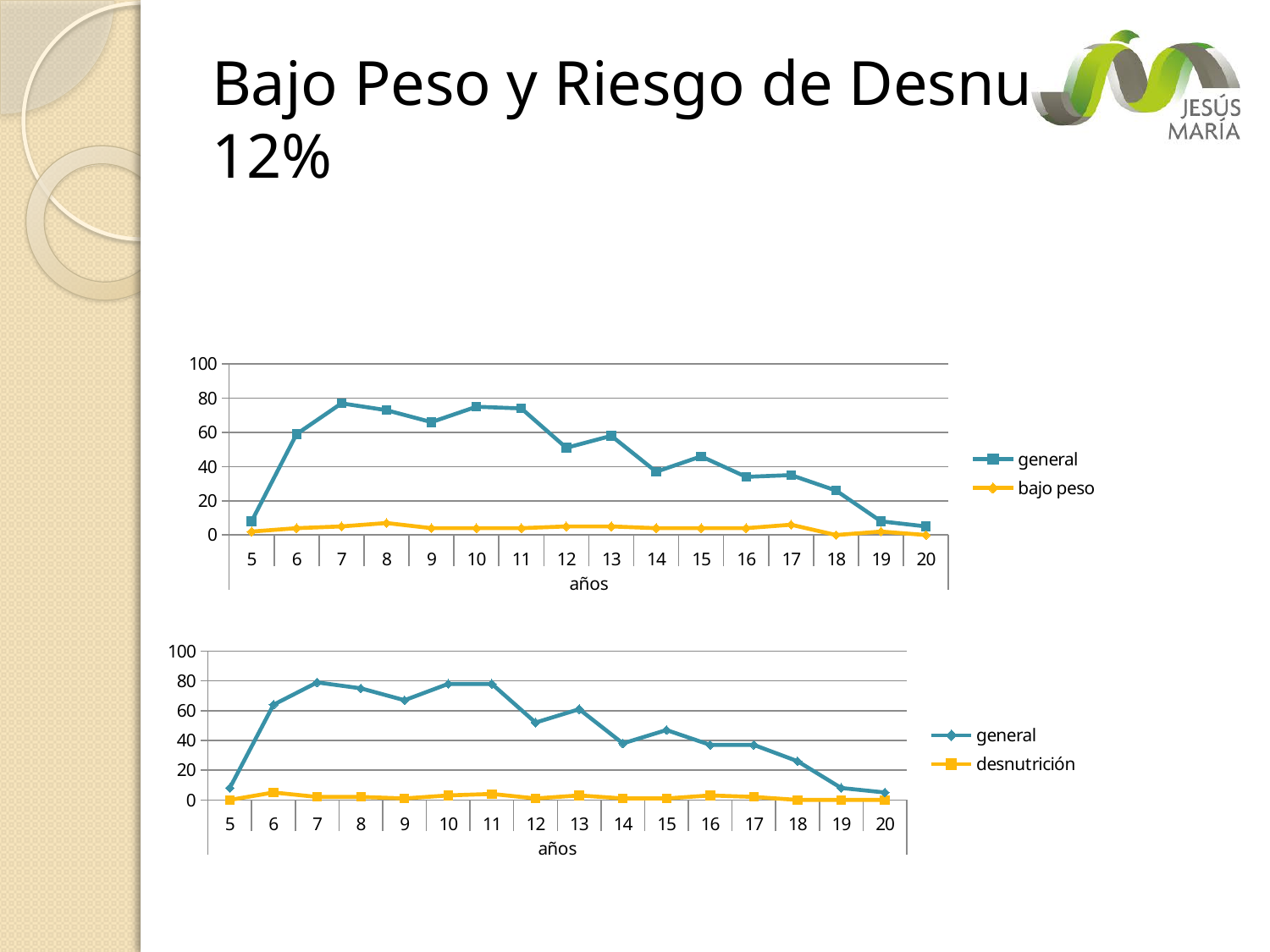
In the bottom chart, which is larger for the 'general' series: the value at 7 años or at 12 años? 7 años In the top chart, is the value of the 'general' series at 5 años greater or less than 20? less In the bottom chart, is the value of the 'general' series at 9 años greater or less than 60? greater In the top chart, which is larger for the 'general' series: the value at 6 años or at 14 años? 6 años In the bottom chart, is the value of the 'general' series at 18 años greater or less than 40? less In the top chart, how many points along the x axis (años) are plotted for each series? 16 How many series does the legend of the bottom chart list? 2 What is the x-axis title of the bottom chart? años What kind of chart is the top chart on the slide? line chart In the bottom chart, does the 'general' series generally rise or fall from 11 años to 20 años? fall